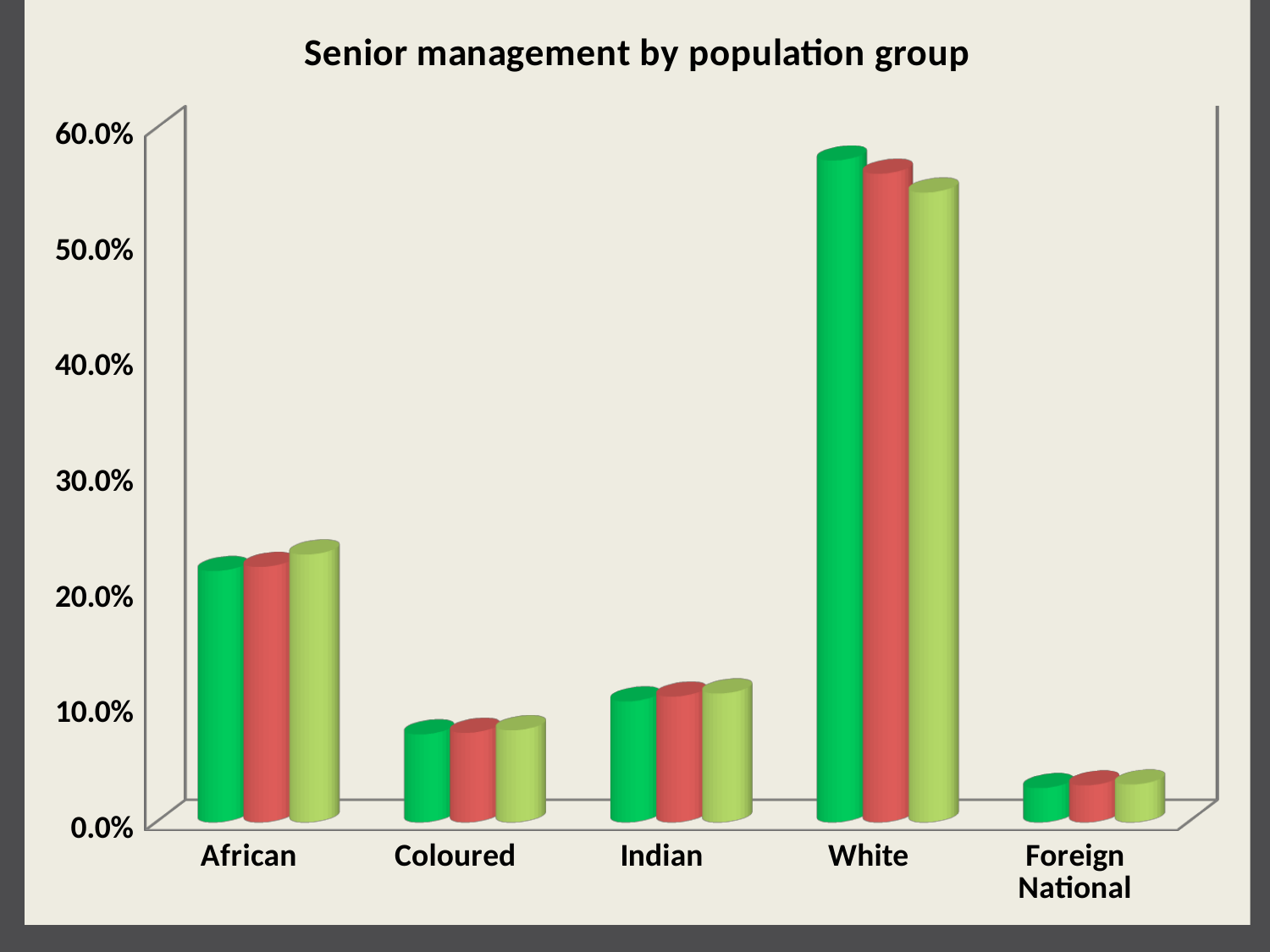
Are the values for Foreign National greater or less than 10.0%? less What type of chart is shown on the slide? bar chart What is the title of the chart? Senior management by population group Which population group has the highest senior management share? White Are the values for White greater or less than 50.0%? greater Which has the larger senior management share, African or Indian? African Are the values for Coloured greater or less than 10.0%? less Which has the larger senior management share, Coloured or Foreign National? Coloured How many bars are plotted for each population group? 3 How many population group categories are shown on the x axis? 5 Which population group has the lowest senior management share? Foreign National